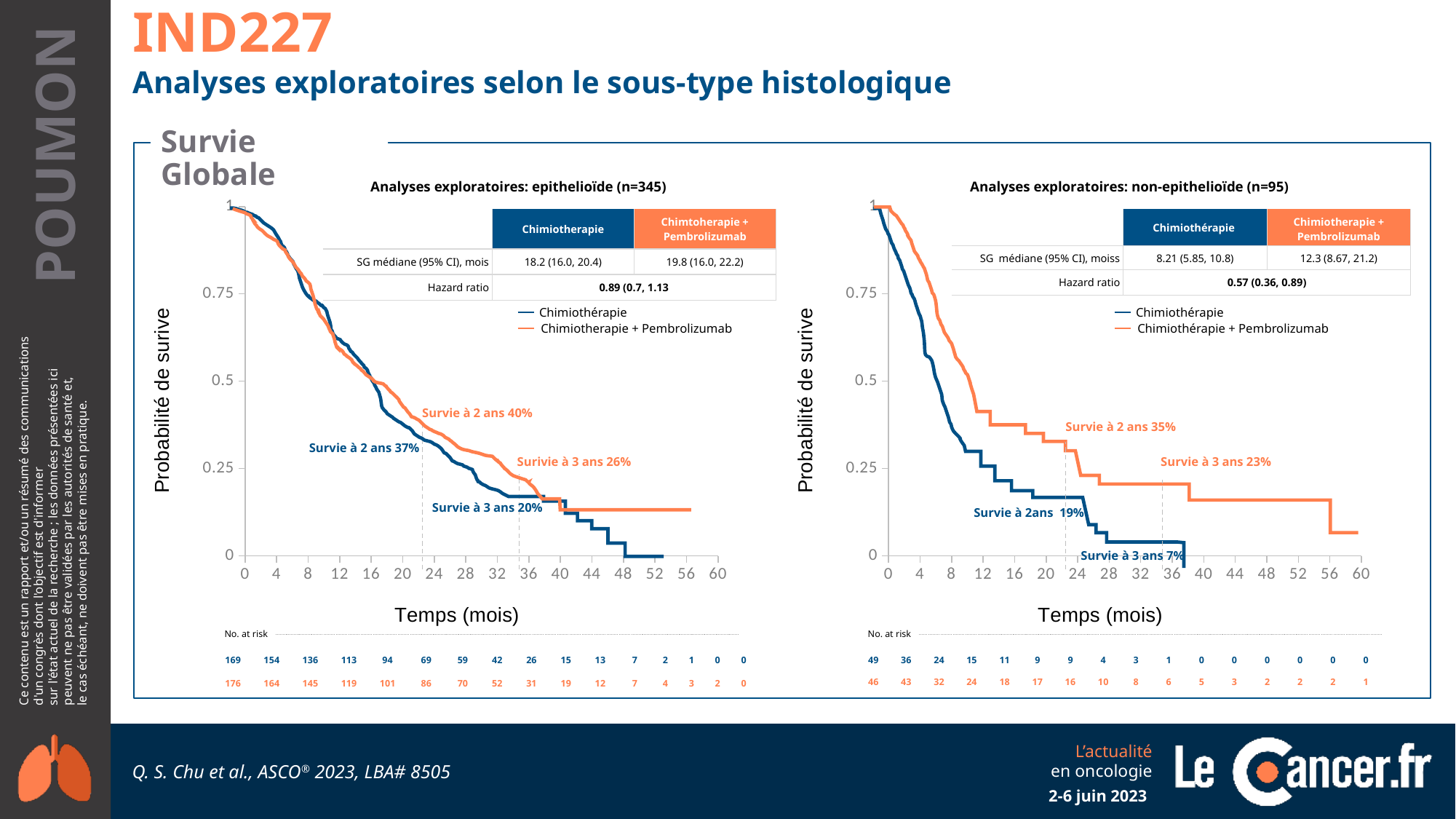
In the epithelioïde chart, what is the 2-year survival for the Chimiotherapie + Pembrolizumab arm? 40% In the epithelioïde chart, what is the 3-year survival for the Chimiothérapie arm? 20% In the non-epithelioïde chart, what is the 2-year survival for the Chimiothérapie + Pembrolizumab arm? 35% In the non-epithelioïde chart, what is the difference in 3-year survival between the Chimiothérapie + Pembrolizumab arm and the Chimiothérapie arm? 16% In the non-epithelioïde chart, which arm has the higher 2-year survival? Chimiothérapie + Pembrolizumab In the epithelioïde chart, what is the difference in 2-year survival between the two arms? 3% Do the survival curves in the epithelioïde chart rise or fall along the x axis? fall In the non-epithelioïde chart, what is the 3-year survival for the Chimiothérapie arm? 7% In the epithelioïde chart, what is the hazard ratio shown in the table? 0.89 (0.7, 1.13) In the non-epithelioïde chart, how many patients are at risk at time 0 in the Chimiothérapie arm? 49 In the non-epithelioïde chart, what is the median overall survival for the Chimiothérapie + Pembrolizumab arm? 12.3 (8.67, 21.2) How many series does the legend of the epithelioïde chart list? 2